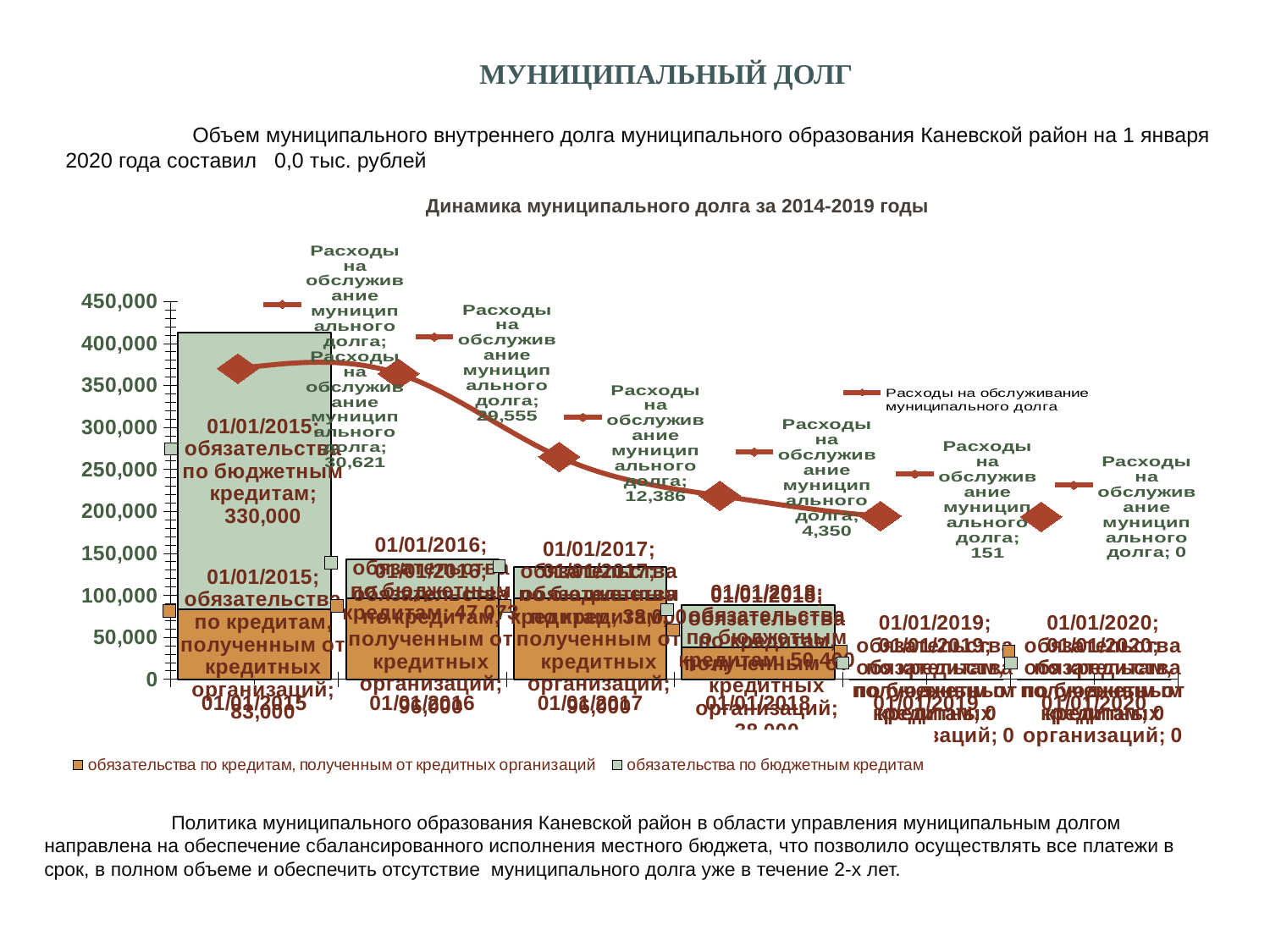
What is the value of обязательства по кредитам, полученным от кредитных организаций on 01/01/2018? 38,000 What is the title of the chart? Динамика муниципального долга за 2014-2019 годы What is the total of the stacked bar for 01/01/2015? 413,000 What is the value of обязательства по кредитам, полученным от кредитных организаций on 01/01/2015? 83,000 How many series does the legend at the bottom of the chart list? 2 What is the value of Расходы на обслуживание муниципального долга on 01/01/2019? 151 Do the values of Расходы на обслуживание муниципального долга rise or fall from 01/01/2015 to 01/01/2020? fall How many dates are plotted along the x axis of the chart? 6 On 01/01/2015, how much larger are обязательства по бюджетным кредитам than обязательства по кредитам, полученным от кредитных организаций? 247,000 What is the value of Расходы на обслуживание муниципального долга on 01/01/2018? 4,350 What is the value of обязательства по бюджетным кредитам on 01/01/2015? 330,000 What kind of chart is shown on the slide? stacked bar chart with a line